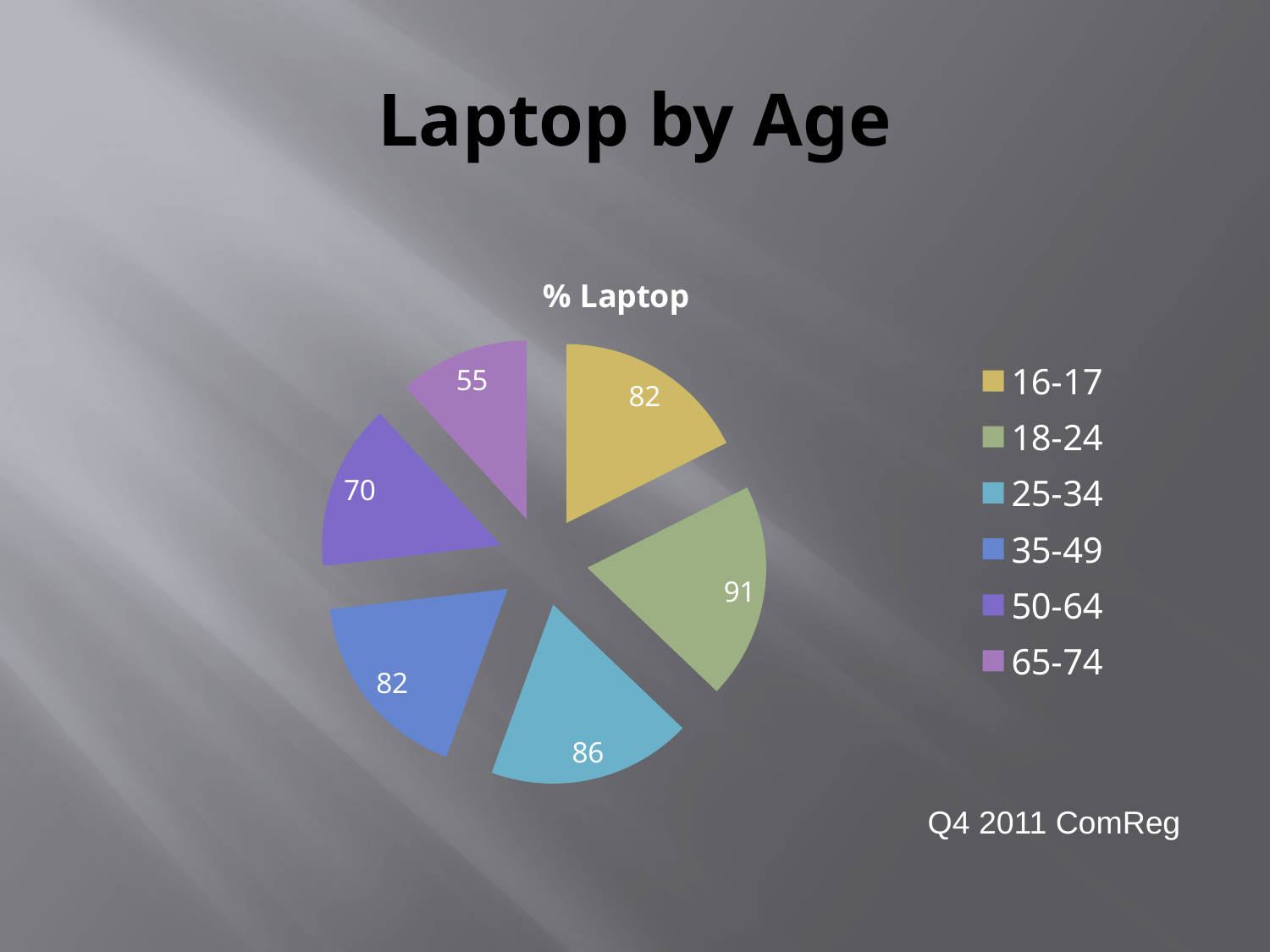
What is the title of the chart? % Laptop What colour is the slice for the 16-17 age group? Yellow What is the value for the 25-34 age group? 86 What is the difference between the values for the 18-24 and 65-74 age groups? 36 What is the value for the 50-64 age group? 70 What type of chart is shown on the slide? Pie chart Which age group has the highest value? 18-24 Which age group has the lowest value? 65-74 Which has a larger value, the 25-34 age group or the 50-64 age group? 25-34 What is the value for the 65-74 age group? 55 How many age groups are shown in the pie chart? 6 What is the value for the 18-24 age group? 91